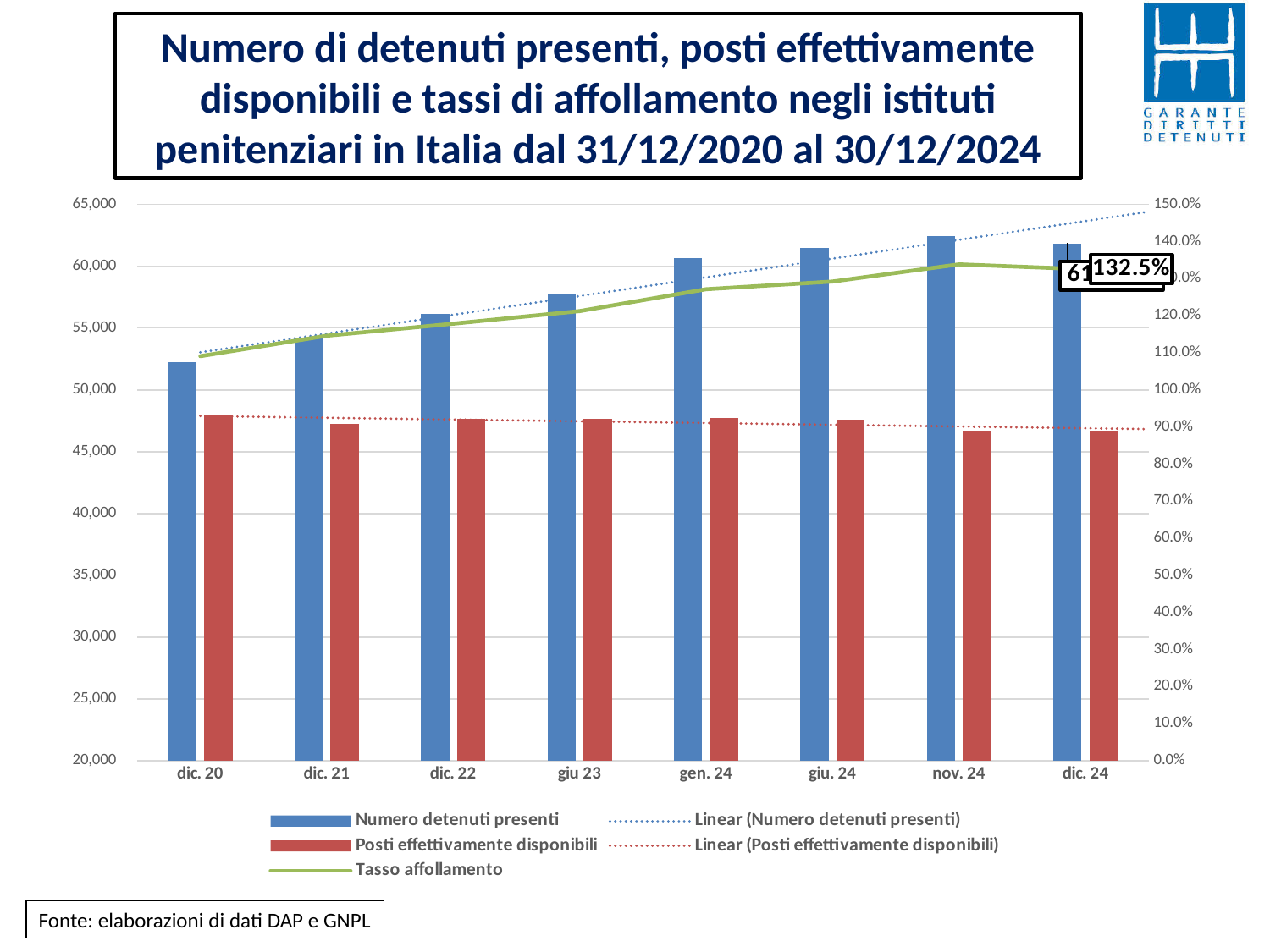
Is the value for Numero detenuti presenti at dic. 21 greater or less than 55,000? less How many entries does the legend list? 5 Is the value for Numero detenuti presenti at dic. 20 greater or less than 50,000? greater Which period has the highest value for Numero detenuti presenti? nov. 24 Does the Numero detenuti presenti series generally rise or fall from dic. 20 to nov. 24? rise Is the value for Posti effettivamente disponibili at dic. 20 greater or less than 50,000? less Which is larger at giu. 24: Numero detenuti presenti or Posti effettivamente disponibili? Numero detenuti presenti What colour are the bars for Posti effettivamente disponibili? Red Which period has the lowest value for Numero detenuti presenti? dic. 20 What is the data label shown for Tasso affollamento at dic. 24? 132.5% How many periods are shown on the x axis? 8